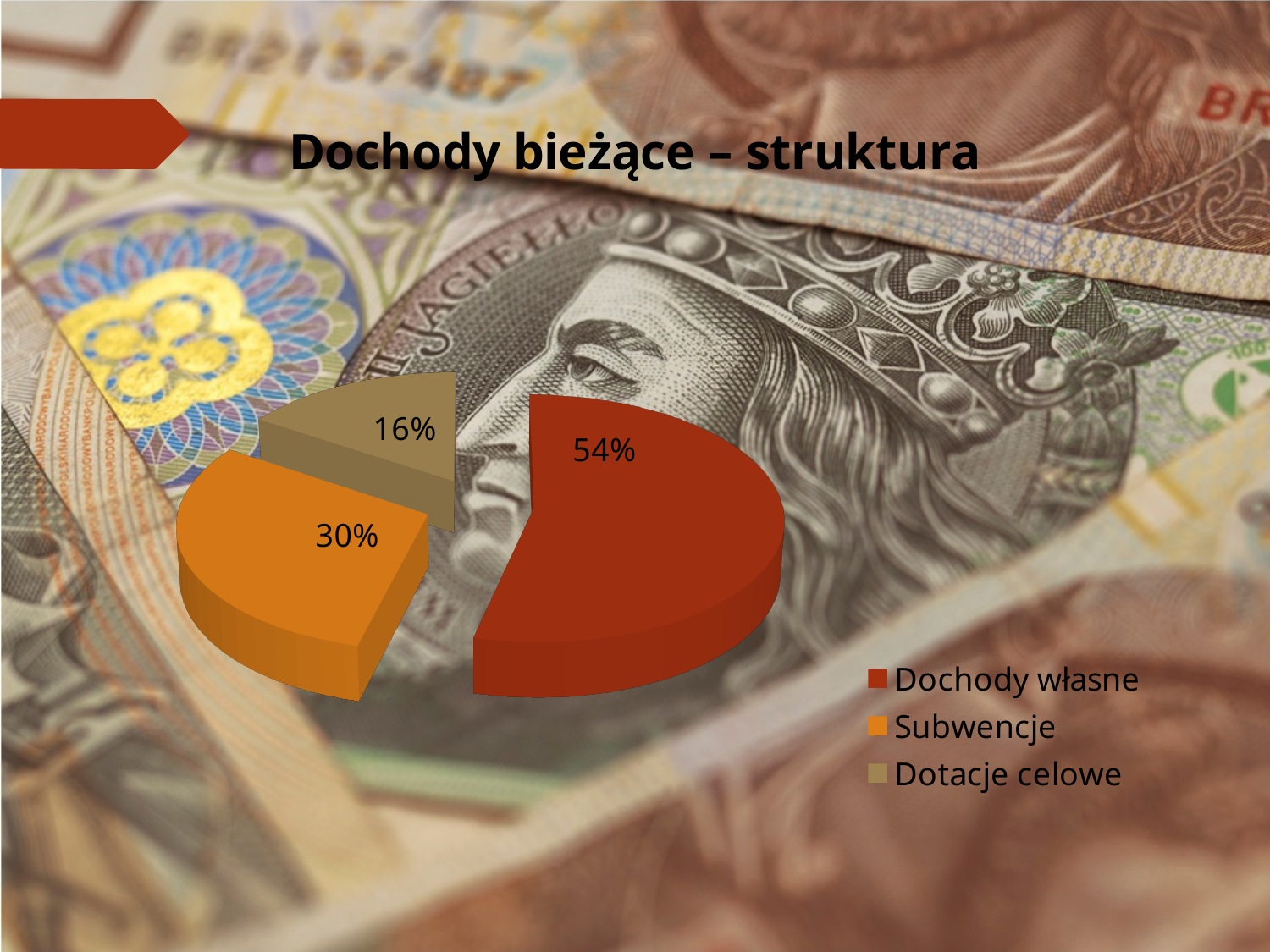
Which is larger, the share of Subwencje or the share of Dotacje celowe? Subwencje What share of the pie does Dotacje celowe have? 16% How many entries does the legend list? 3 How many slices does the pie chart have? 3 What is the difference between the shares of Dochody własne and Subwencje? 24% What colour is the slice for Subwencje? orange What share of the pie does Subwencje have? 30% Which category has the smallest share of the pie? Dotacje celowe What is the title of the chart? Dochody bieżące – struktura What type of chart is shown on the slide? pie chart What share of the pie does Dochody własne have? 54% Which category has the largest share of the pie? Dochody własne